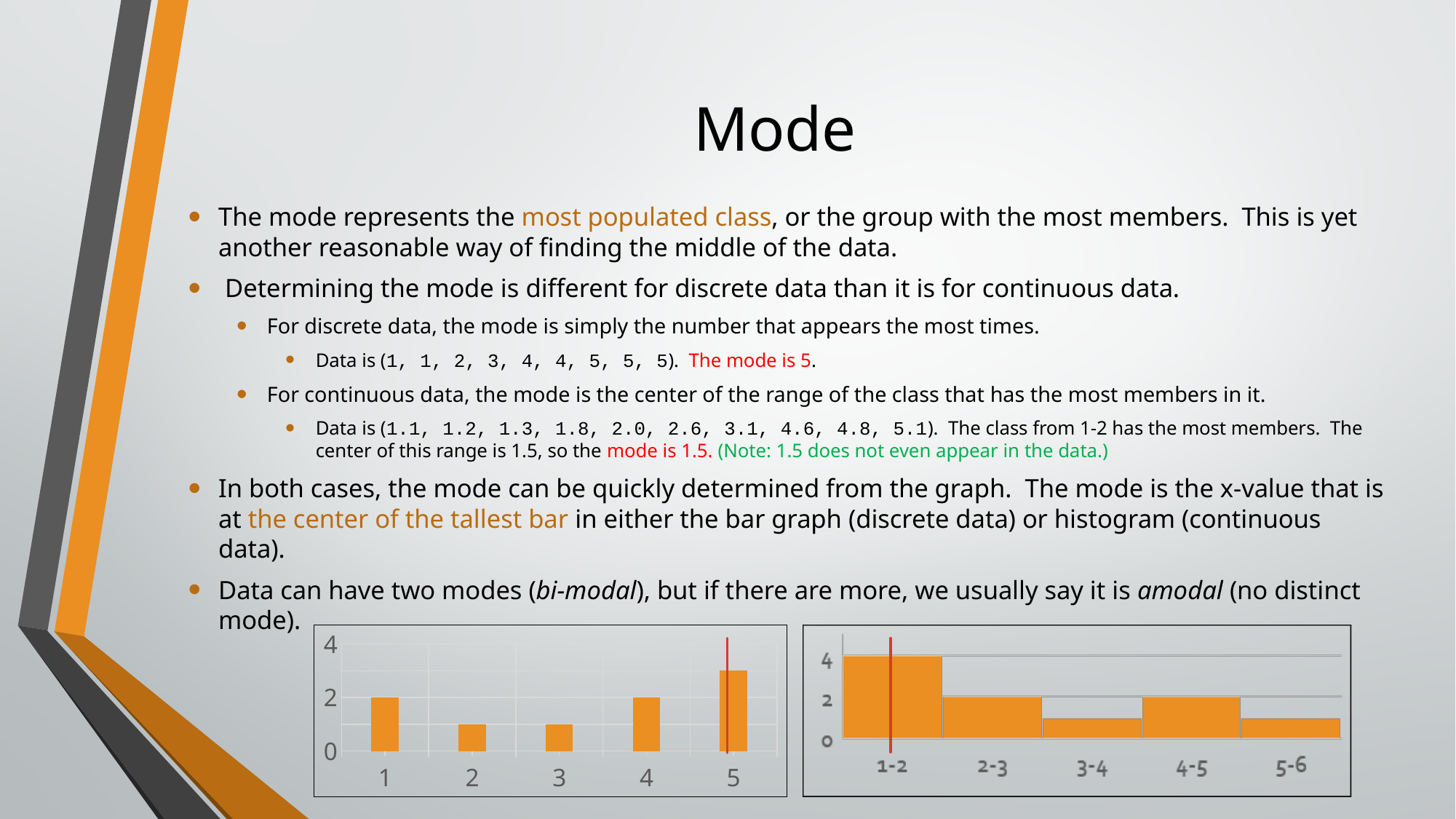
What kind of chart is the chart on the left of the slide? bar chart In the left chart, which has the larger value, category 5 or category 2? 5 How many categories are shown on the x axis of the left chart? 5 In the left chart, what is the value for category 1? 2 In the right chart (histogram), what is the value for the class 1-2? 4 How many classes are shown on the x axis of the right chart (histogram)? 5 In the right chart (histogram), which class has the tallest bar? 1-2 In the left chart, is the value for category 5 greater or less than 2? greater In the right chart (histogram), is the value for the class 3-4 greater or less than 2? less In the right chart (histogram), what is the difference between the values for the classes 1-2 and 2-3? 2 In the left chart, which category has the tallest bar? 5 In the left chart, what is the value for category 4? 2